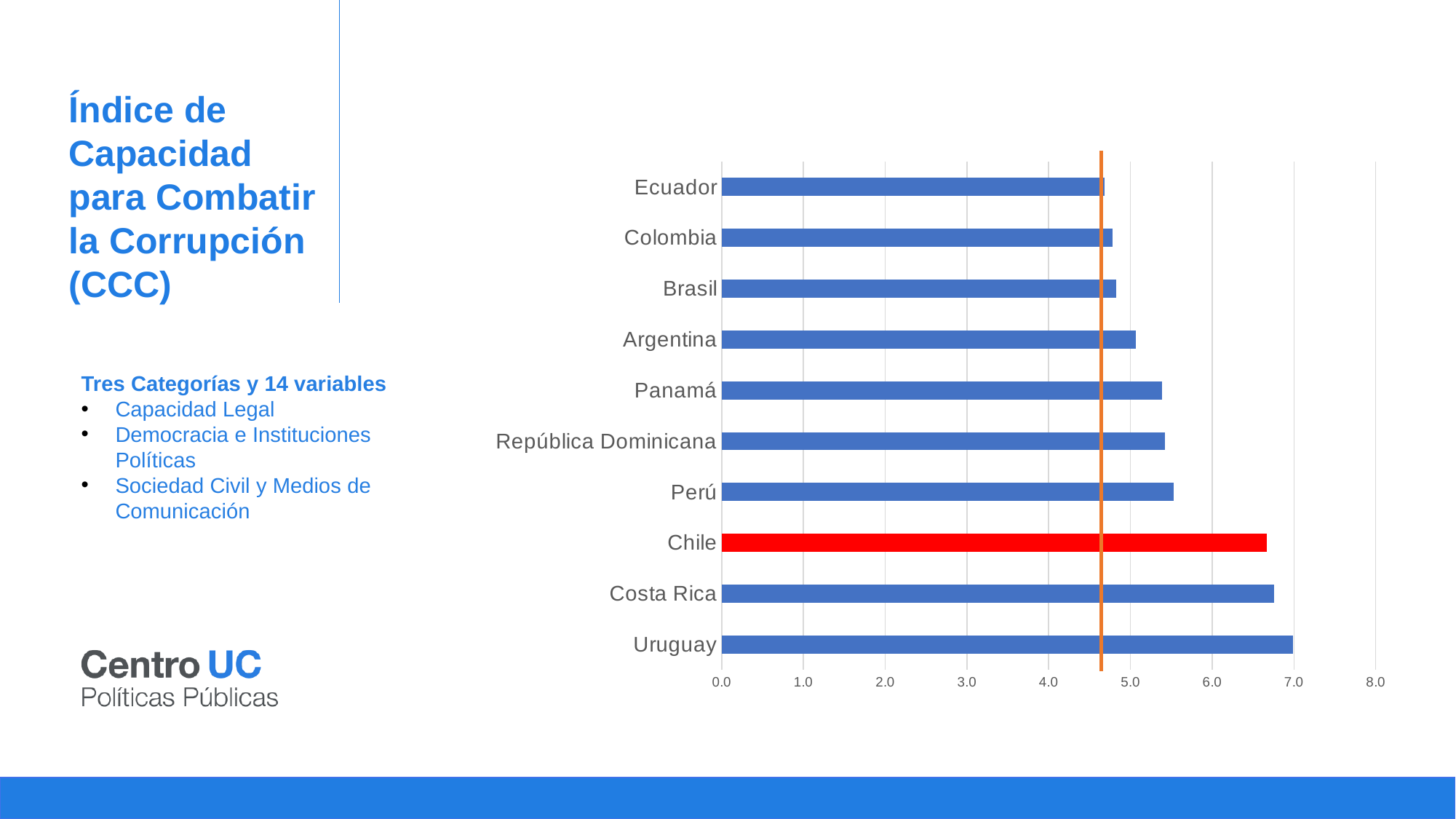
Which country's bar is coloured red in the chart? Chile Which country has the highest value in the chart? Uruguay Which has a larger value, Panamá or Argentina? Panamá Is the value for Costa Rica greater or less than 6.0? greater How many countries are shown in the chart? 10 Is the value for Brasil greater or less than 5.0? less Which has a larger value, Chile or Perú? Chile Is the value for Ecuador greater or less than 5.0? less Which country has the lowest value in the chart? Ecuador What kind of chart is shown on the slide? bar chart